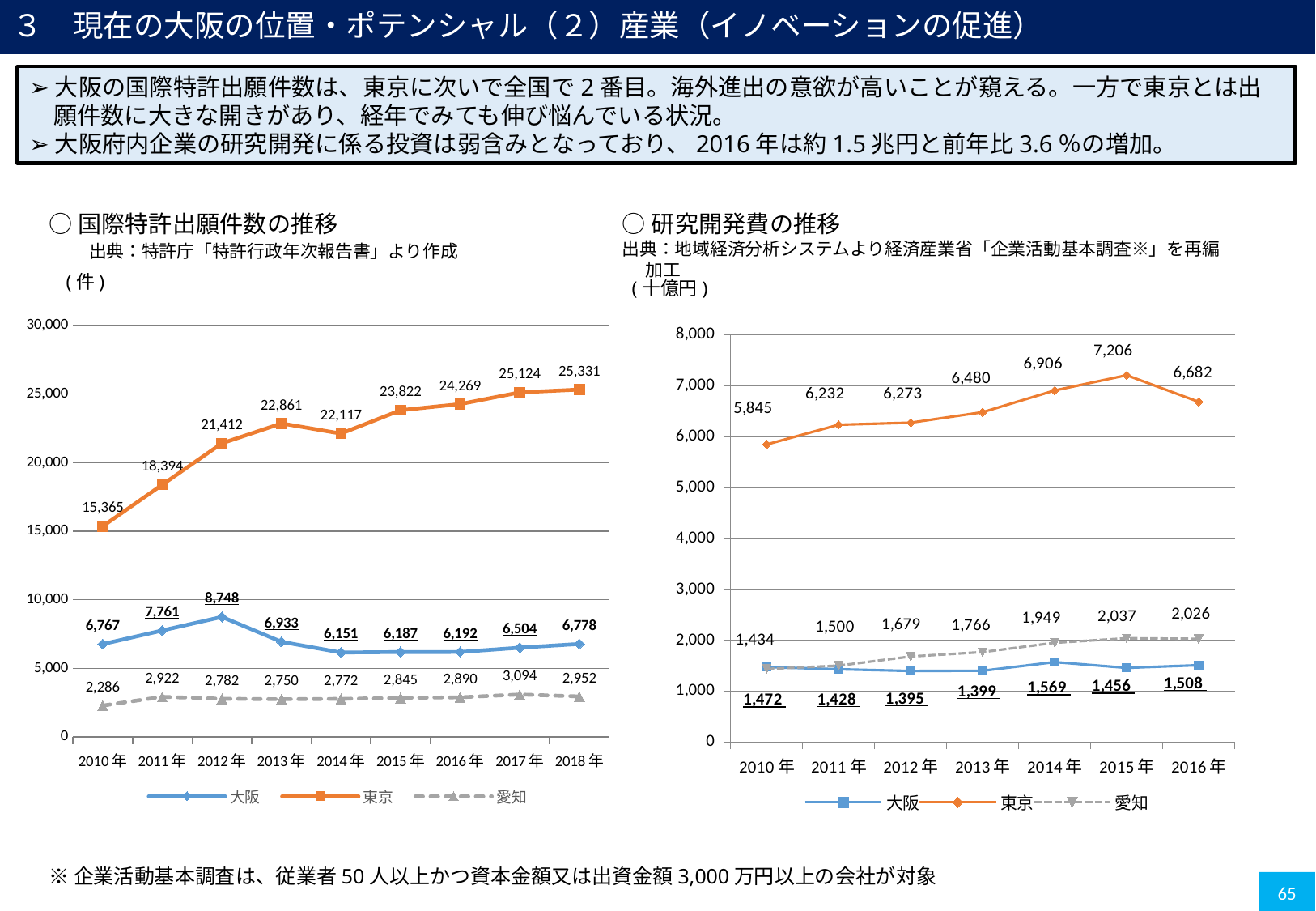
In the 国際特許出願件数の推移 chart on the left, in which year is the 大阪 series highest? 2012年 In the 国際特許出願件数の推移 chart on the left, what is the value for 大阪 in 2012年? 8,748 In the 国際特許出願件数の推移 chart on the left, how many years are plotted on the x axis? 9 In the 国際特許出願件数の推移 chart on the left, does the 東京 series generally rise or fall from 2010年 to 2018年? rise In the 研究開発費の推移 chart on the right, which is larger in 2016年, 愛知 or 大阪? 愛知 In the 研究開発費の推移 chart on the right, what is the value for 東京 in 2015年? 7,206 What kind of chart is the 研究開発費の推移 chart on the right? line chart In the 研究開発費の推移 chart on the right, what is the value for 大阪 in 2016年? 1,508 In the 研究開発費の推移 chart on the right, how many series does the legend list? 3 In the 国際特許出願件数の推移 chart on the left, what is the difference between 東京 and 大阪 in 2018年? 18,553 In the 研究開発費の推移 chart on the right, in which year is the 大阪 series lowest? 2012年 In the 国際特許出願件数の推移 chart on the left, what is the value for 東京 in 2018年? 25,331